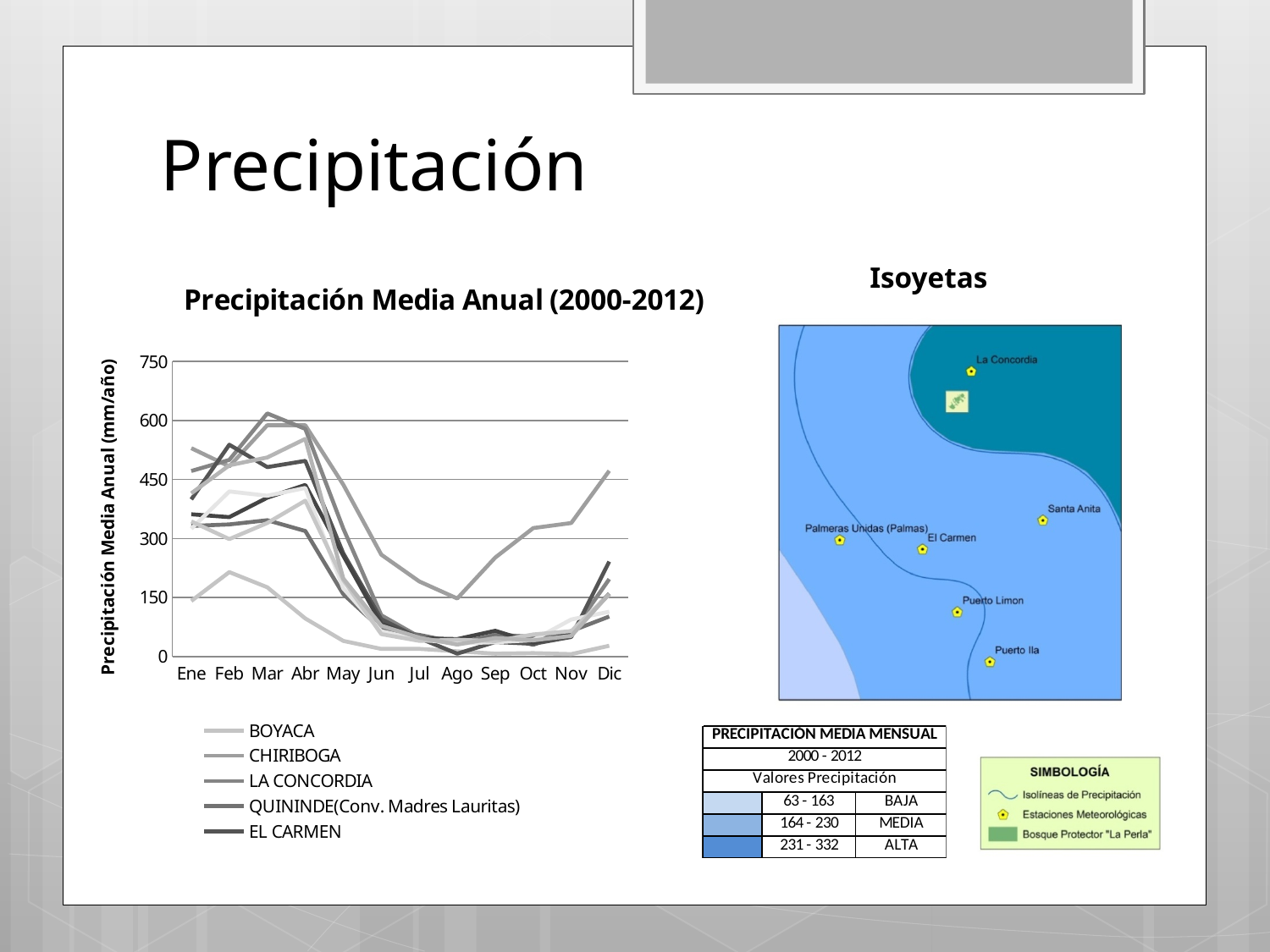
In the 'Precipitación Media Anual (2000-2012)' chart, do the values for the stations rise or fall from Abr to Jul? fall In the 'Precipitación Media Anual (2000-2012)' chart, is the value for EL CARMEN in Ago greater or less than 150? less In the 'Precipitación Media Anual (2000-2012)' chart, is the value for BOYACA in Ene larger or smaller than its value in Feb? smaller What kind of chart is 'Precipitación Media Anual (2000-2012)'? line chart In the 'Precipitación Media Anual (2000-2012)' chart, is the value for BOYACA in Jul greater or less than 150? less Which station is listed last in the legend of the 'Precipitación Media Anual (2000-2012)' chart? EL CARMEN What is the highest value shown on the y axis of the 'Precipitación Media Anual (2000-2012)' chart? 750 How many series does the legend of the 'Precipitación Media Anual (2000-2012)' chart list? 5 How many months are shown on the x axis of the 'Precipitación Media Anual (2000-2012)' chart? 12 What is the title of the y axis on the 'Precipitación Media Anual (2000-2012)' chart? Precipitación Media Anual (mm/año) In the 'Precipitación Media Anual (2000-2012)' chart, is the value for BOYACA in Feb greater or less than 150? greater